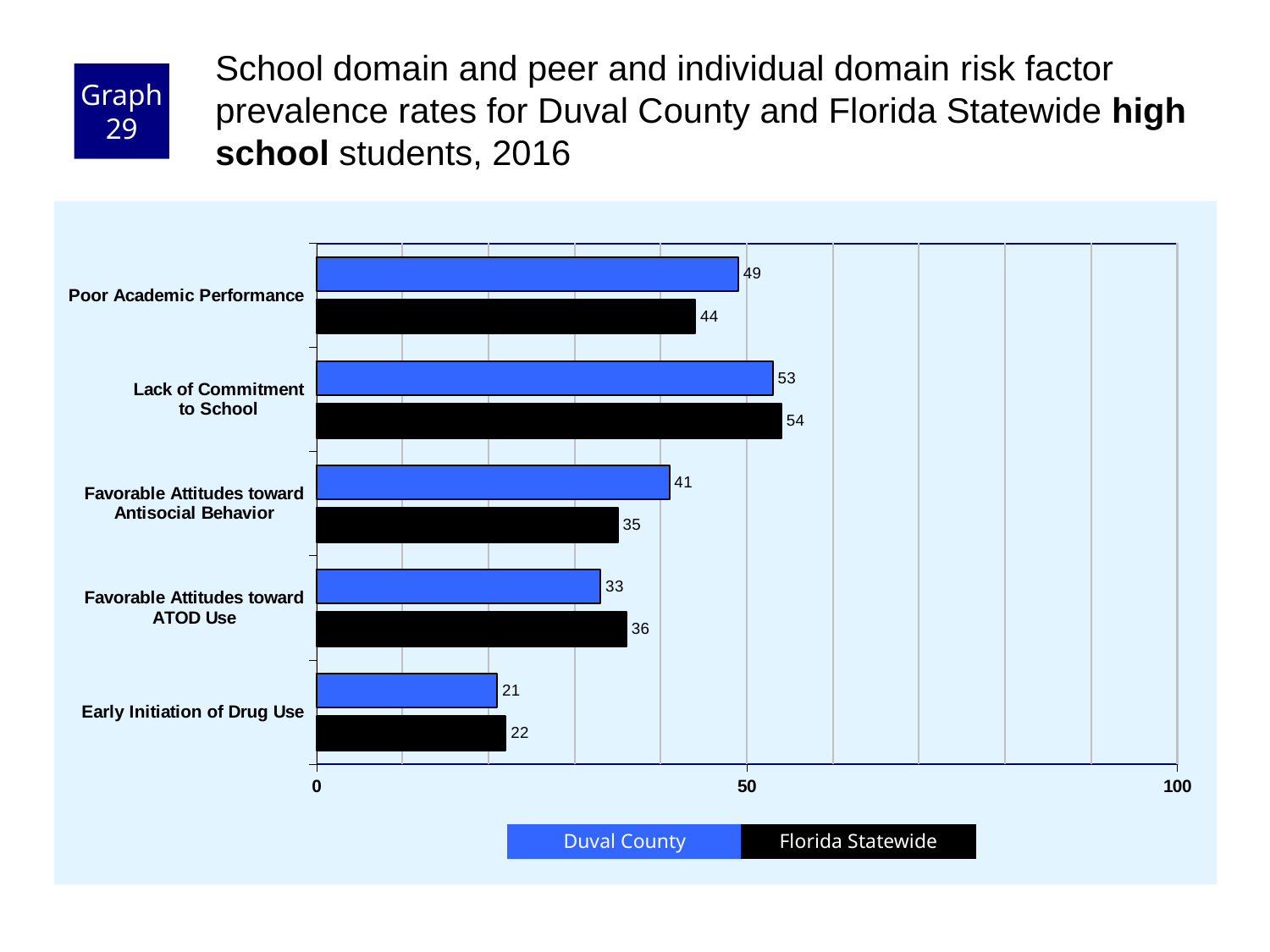
How many risk factor categories are shown in the chart? 5 What is the difference between the Duval County and Florida Statewide values for Poor Academic Performance? 5 What kind of chart is shown on the slide? Bar chart Which risk factor has the lowest Florida Statewide value? Early Initiation of Drug Use Is the Florida Statewide value for Lack of Commitment to School greater or less than 50? greater What is the difference between the Duval County and Florida Statewide values for Favorable Attitudes toward Antisocial Behavior? 6 What is the Duval County value for Early Initiation of Drug Use? 21 How many series does the legend list? 2 Which risk factor has the highest Duval County value? Lack of Commitment to School What is the Duval County value for Poor Academic Performance? 49 For Favorable Attitudes toward ATOD Use, which is larger: Duval County or Florida Statewide? Florida Statewide What is the Florida Statewide value for Favorable Attitudes toward ATOD Use? 36